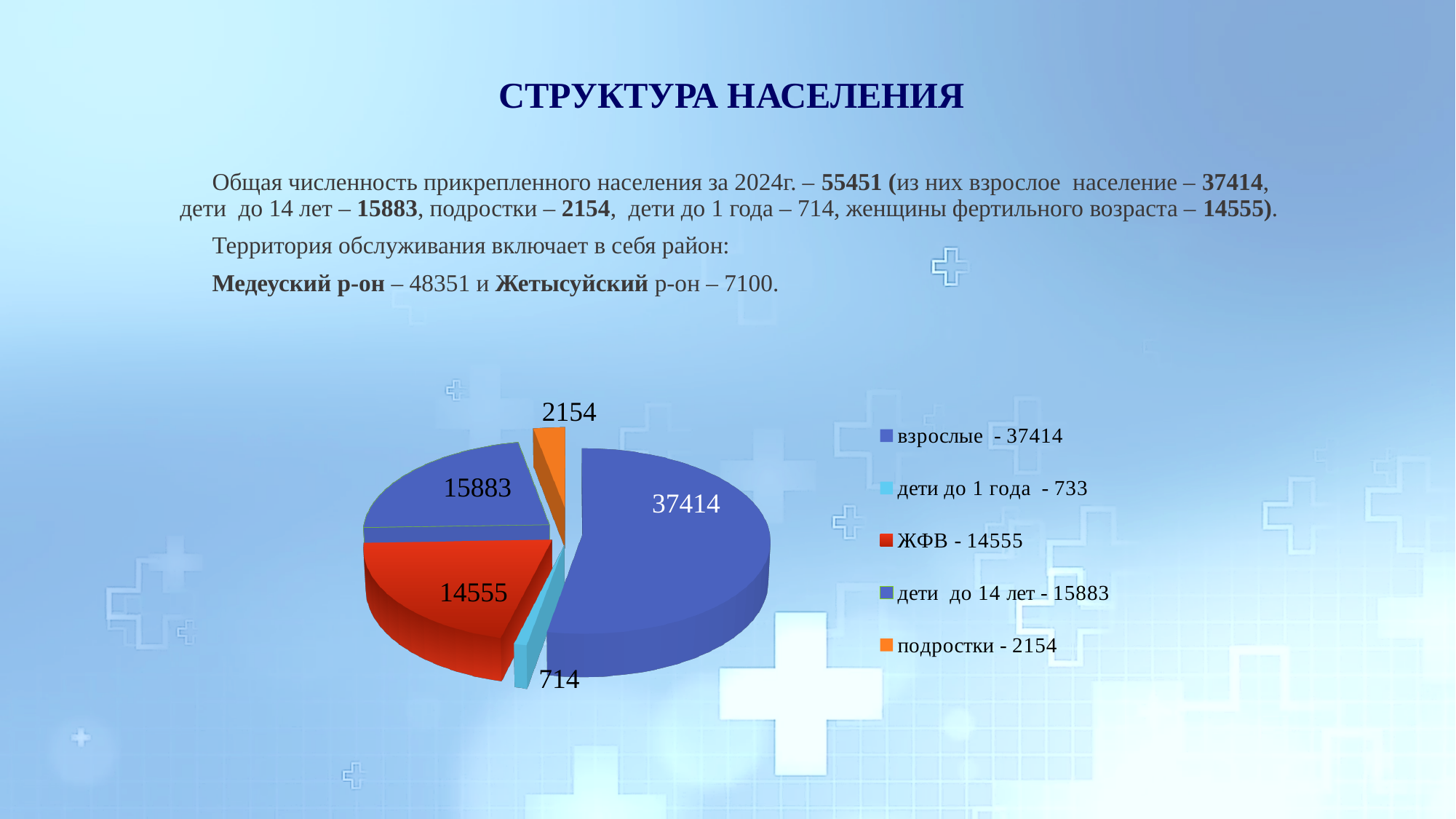
What value is shown for the ЖФВ slice of the pie chart? 14555 What value is shown for the дети до 14 лет slice of the pie chart? 15883 Which is larger in the pie chart, ЖФВ or подростки? ЖФВ What value is shown for the взрослые slice of the pie chart? 37414 What is the difference between the дети до 14 лет value and the ЖФВ value in the pie chart? 1328 What colour is the подростки slice in the pie chart? orange Which category has the largest slice in the pie chart? взрослые What kind of chart is shown on the slide? pie chart Which category has the smallest slice in the pie chart? дети до 1 года What value is shown for the подростки slice of the pie chart? 2154 How many slices does the pie chart have? 5 What is the difference between the взрослые value and the дети до 14 лет value in the pie chart? 21531